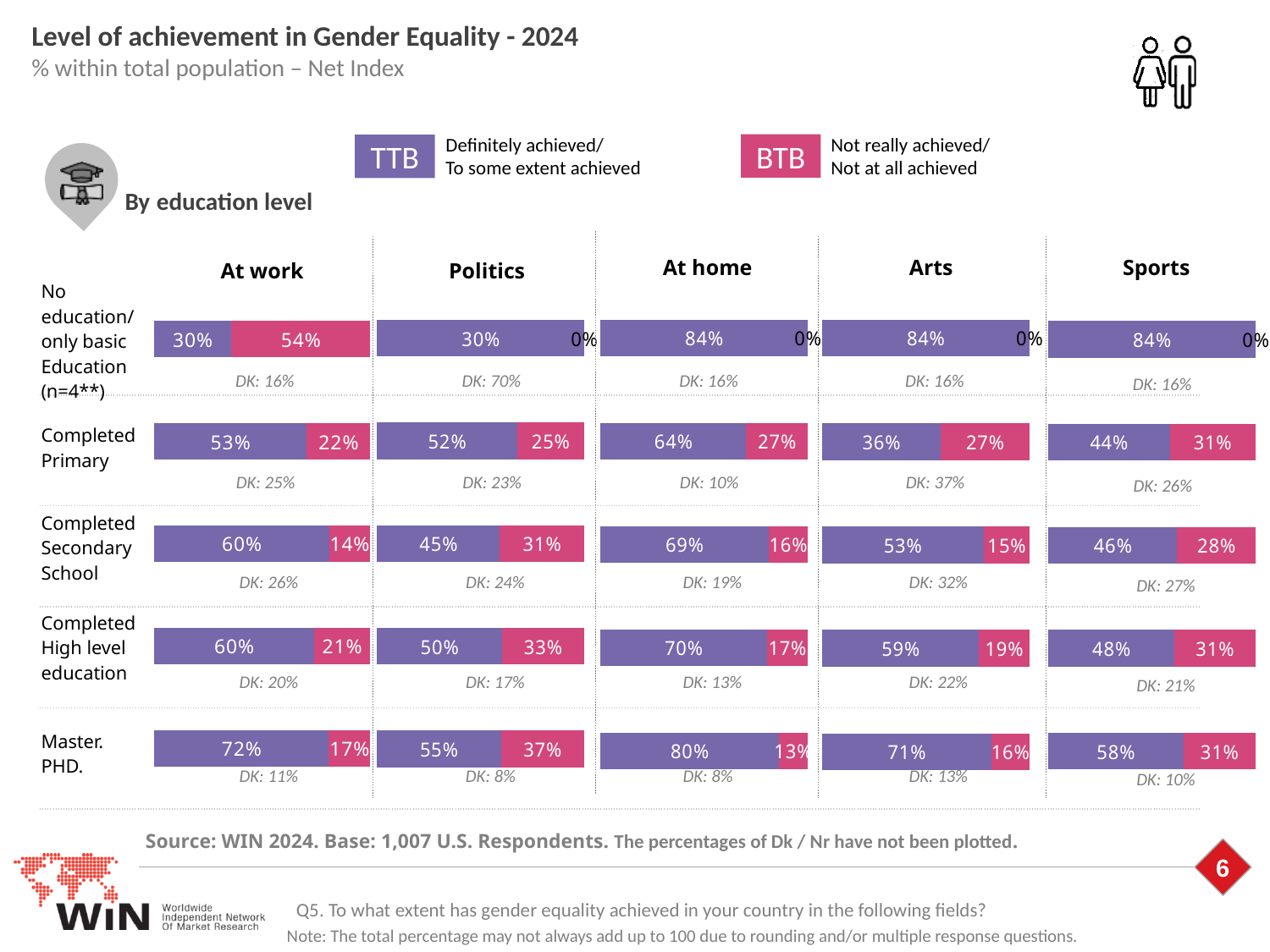
In the 'Politics' chart, what is the BTB value for Completed High level education? 33% In the 'Politics' chart, which has the larger TTB value: Master. PHD. or Completed Secondary School? Master. PHD. What colour represents TTB in the charts? Purple How many education levels are shown in each chart? 5 In the 'At home' chart, which education level has the highest TTB value? No education/only basic Education What kind of chart is used on this slide? Stacked bar chart How many series does the legend list? 2 In the 'Sports' chart, what is the difference between the TTB and BTB values for Master. PHD.? 27 percentage points In the 'Arts' chart, what is the BTB value for Completed Secondary School? 15% In the 'At work' chart, what is the total of the TTB and BTB values for Completed Primary? 75% In the 'Arts' chart, which education level has the lowest TTB value? Completed Primary In the 'At work' chart, what is the TTB value for Master. PHD.? 72%